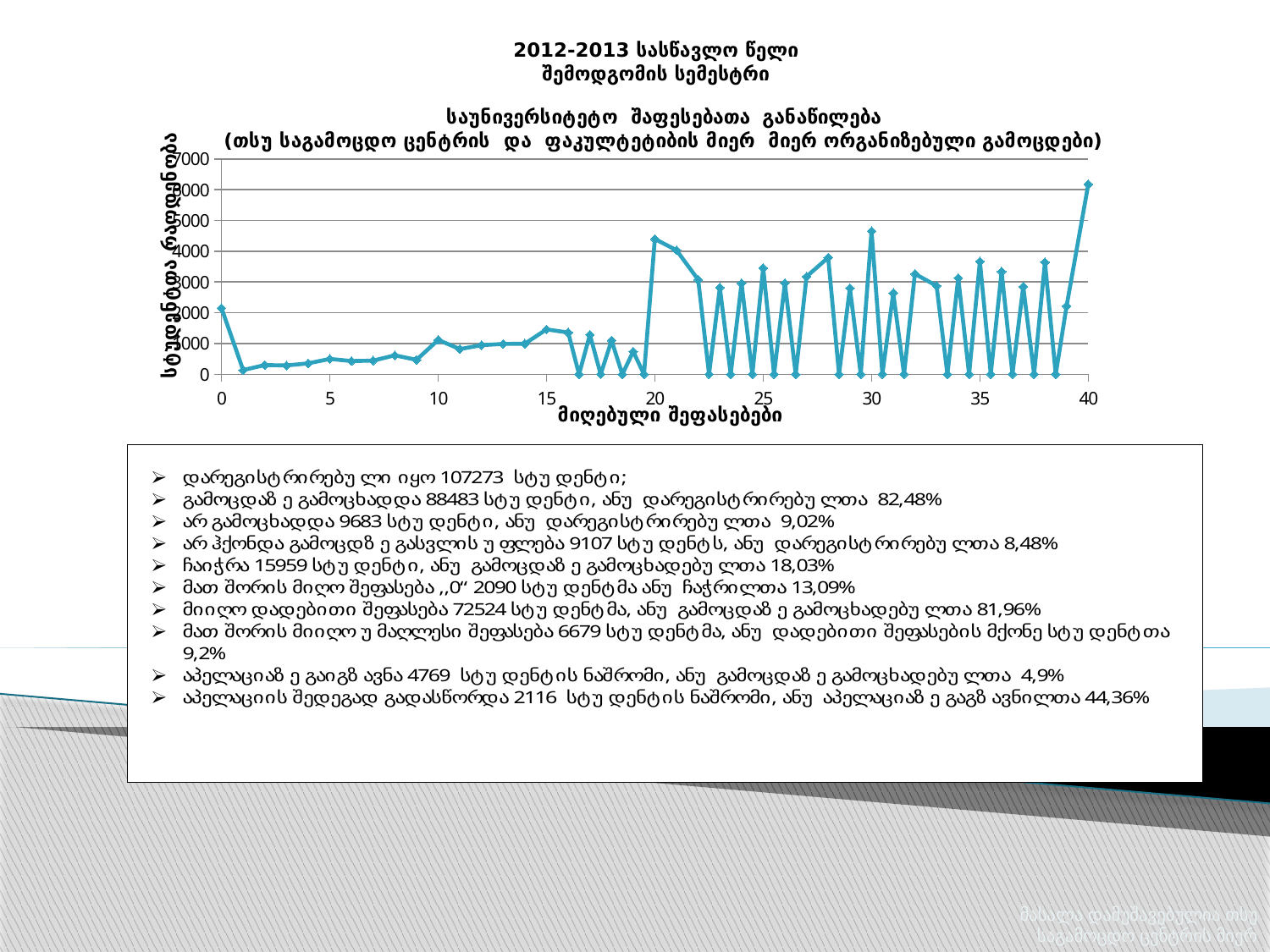
Is the value at score 1 greater or less than 1000? less Is the value at score 0 greater or less than 1000? greater Is the value at score 30 greater or less than 4000? greater What kind of chart is shown on the slide? line chart At which score on the x axis does the line reach its highest value? 40 Which has the larger value, score 40 or score 0? 40 Which has the larger value, score 20 or score 10? 20 What is the label of the x axis? მიღებული შეფასებები How many data series does the chart plot? 1